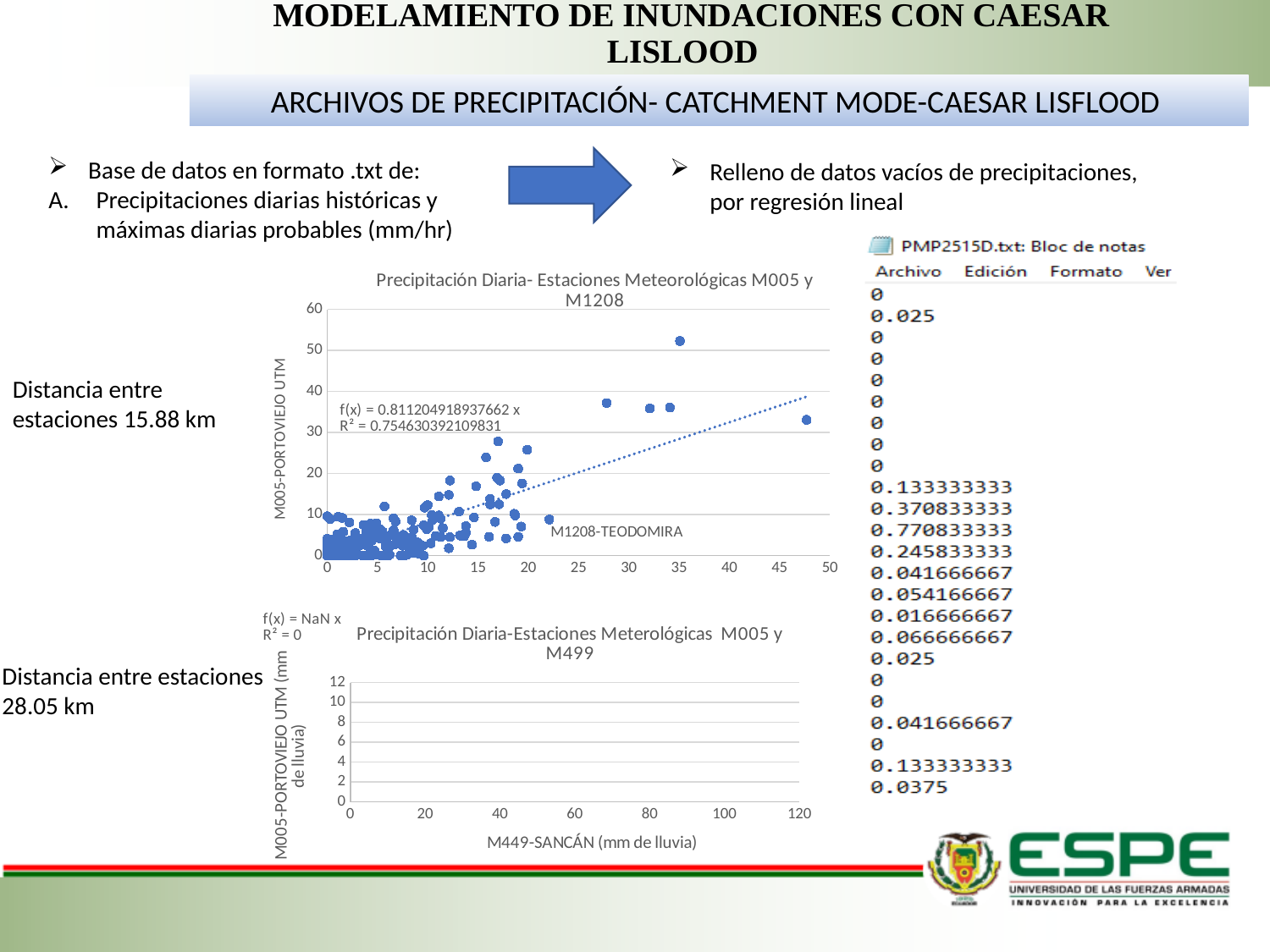
In the top chart (M005 y M1208), what is the maximum value shown on the y axis? 60 In the bottom chart (M005 y M499), what is the maximum value shown on the x axis? 120 What kind of chart is the top chart titled "Precipitación Diaria- Estaciones Meteorológicas M005 y M1208"? Scatter chart In the top chart (M005 y M1208), what is the maximum value shown on the x axis? 50 In the top chart (M005 y M1208), does the trendline rise or fall as the x value increases? Rises In the top chart (M005 y M1208), what is the trendline equation shown? f(x) = 0.811204918937662 x In the top chart (M005 y M1208), what R² value is shown for the trendline? R² = 0.754630392109831 In the top chart (M005 y M1208), is the rightmost plotted point's x value greater or less than 45? greater In the bottom chart (M005 y M499), what is the maximum value shown on the y axis? 12 In the bottom chart (M005 y M499), what is the x axis label? M449-SANCÁN (mm de lluvia) In the top chart (M005 y M1208), is the highest plotted point on the y axis greater or less than 50? greater